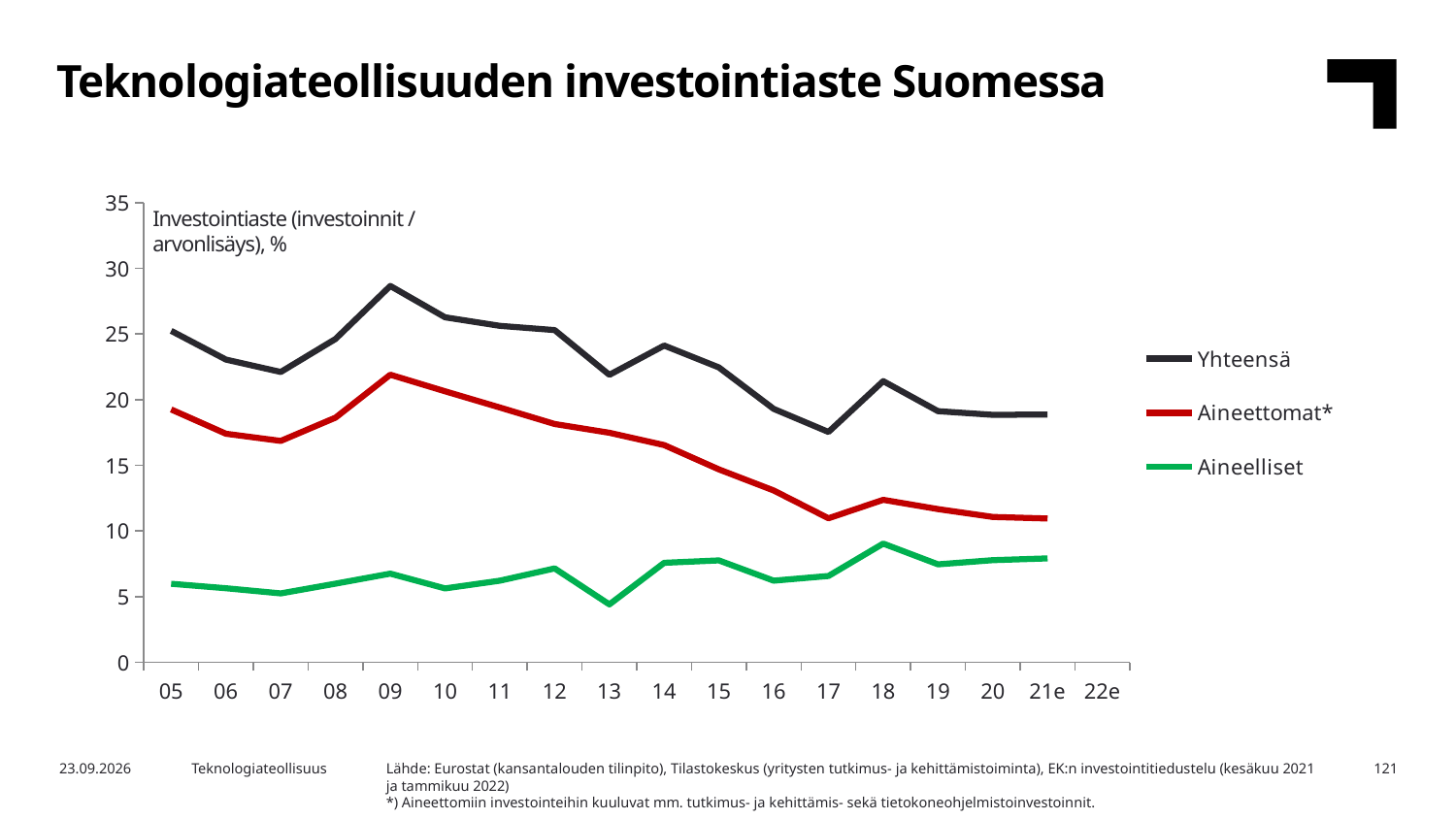
In which year does the Yhteensä series reach its highest value? 09 Is the value for Yhteensä in 09 greater or less than 25? greater Which series has the larger value in 20, Aineettomat* or Aineelliset? Aineettomat* In which year does the Aineelliset series reach its lowest value? 13 What kind of chart is shown on the slide? line chart How many series does the legend list? 3 Does the Aineettomat* series rise or fall from 09 to 17? fall In which year does the Aineettomat* series reach its highest value? 09 In which year does the Yhteensä series reach its lowest value? 17 Is the value for Aineettomat* in 17 greater or less than 15? less Is the value for Yhteensä in 17 greater or less than 20? less